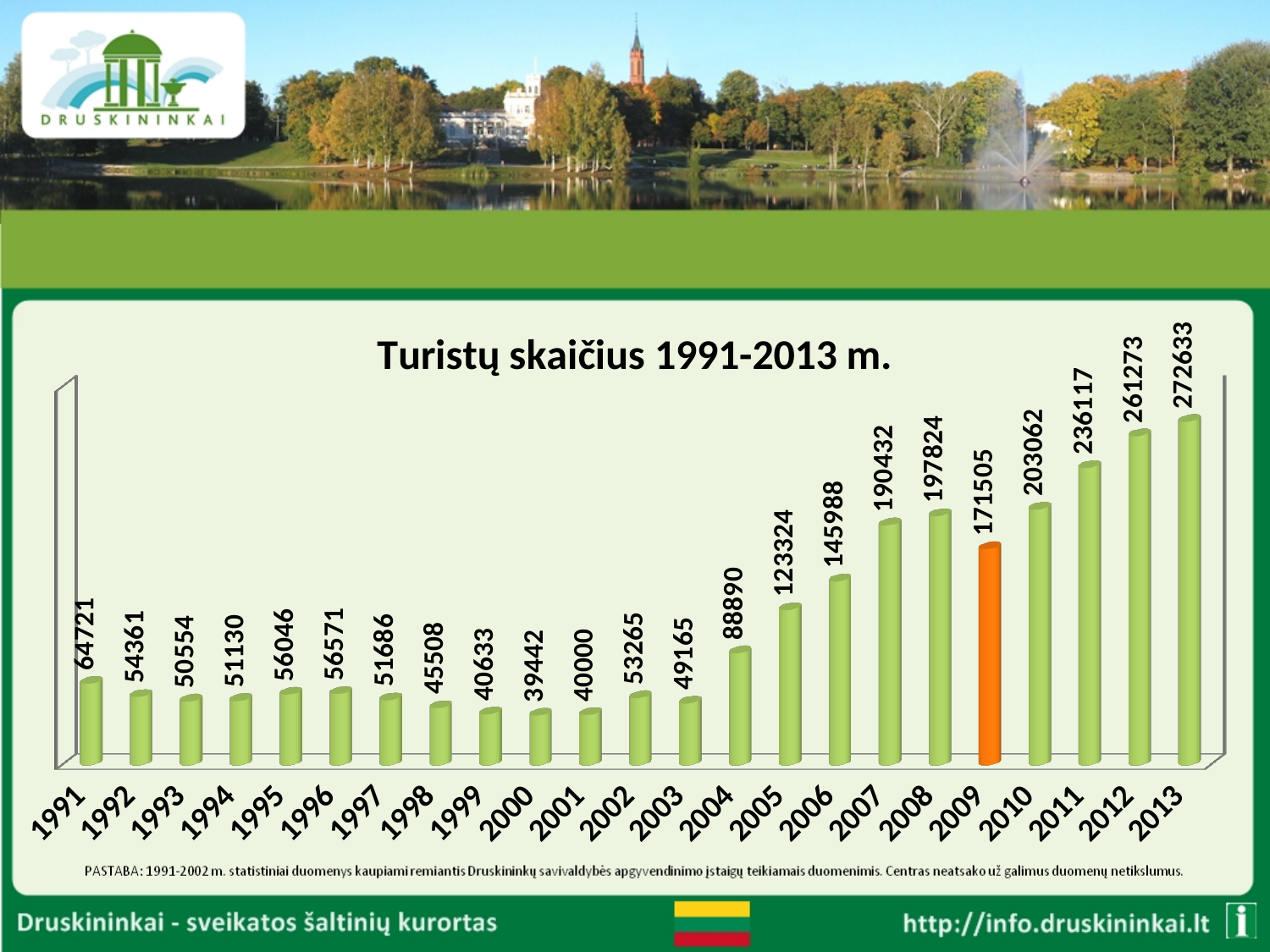
What is the value for 1991? 64721 How many years (bars) are shown in the chart? 23 Which year has the lowest value? 2000 Which is larger, the value for 2007 or the value for 2010? 2010 Which year has the highest value? 2013 What is the difference between the values for 2013 and 2012? 11360 What is the value for 2009? 171505 Which bar is coloured differently (orange) from the others? 2009 What is the title of the chart? Turistų skaičius 1991-2013 m. What is the value for 2005? 123324 What is the difference between the values for 2008 and 2009? 26319 What type of chart is shown on the slide? bar chart